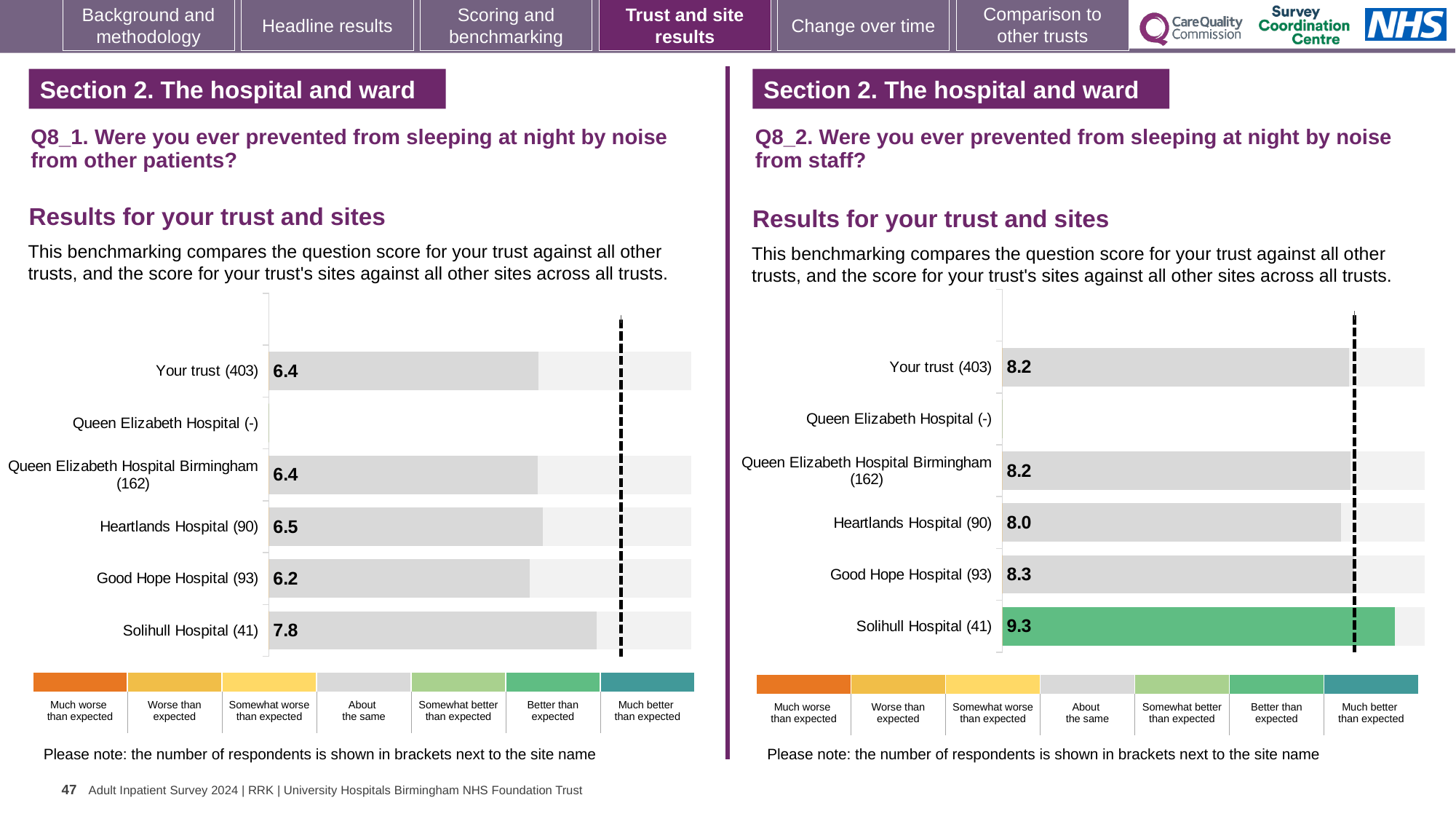
In the Q8_2 chart (right), which is larger: the score for Good Hope Hospital (93) or Heartlands Hospital (90)? Good Hope Hospital (93) In the Q8_2 chart (right), which site has the highest score? Solihull Hospital (41) In the Q8_2 chart (right), what is the difference between the scores for Solihull Hospital (41) and Heartlands Hospital (90)? 1.3 In the Q8_1 chart (left), what is the score for Solihull Hospital (41)? 7.8 In the Q8_2 chart (right), what is the score for Your trust (403)? 8.2 In the Q8_1 chart (left), what is the difference between the scores for Solihull Hospital (41) and Your trust (403)? 1.4 What type of chart is used on the slide? Bar chart In the Q8_2 chart (right), how many bars are plotted with a score? 5 In the Q8_2 chart (right), what is the score for Heartlands Hospital (90)? 8.0 In the Q8_1 chart (left), which site has the highest score? Solihull Hospital (41) In the Q8_1 chart (left), what is the score for Good Hope Hospital (93)? 6.2 In the Q8_1 chart (left), which site has the lowest score? Good Hope Hospital (93)